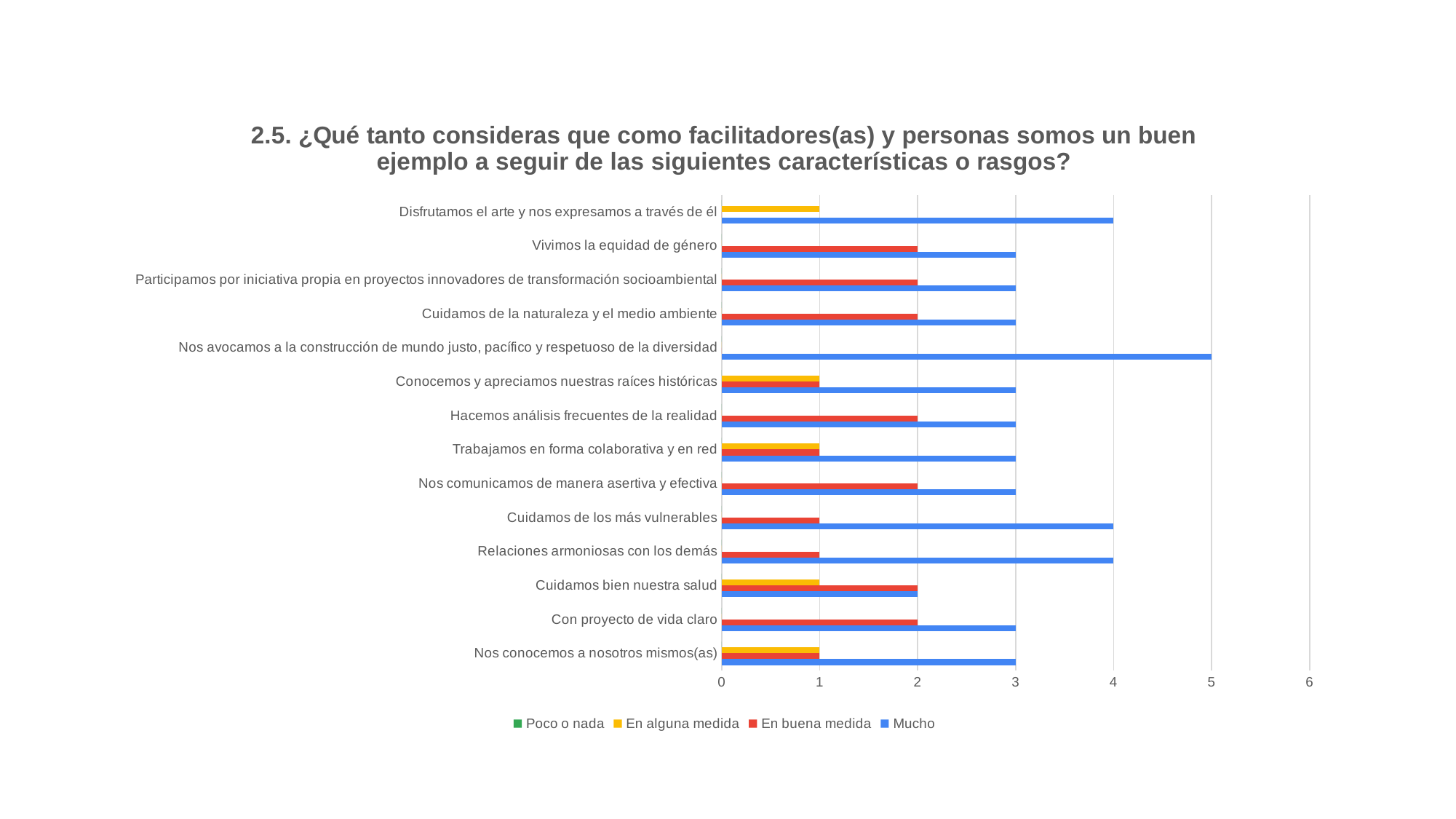
What kind of chart is shown on the slide? bar chart How many series does the legend list? 4 Which legend entry is shown in blue? Mucho Is the 'Mucho' value for 'Nos avocamos a la construcción de mundo justo, pacífico y respetuoso de la diversidad' greater or less than 4? greater What is the value of the 'Mucho' series for 'Nos avocamos a la construcción de mundo justo, pacífico y respetuoso de la diversidad'? 5 What is the value of the 'En buena medida' series for 'Vivimos la equidad de género'? 2 What is the value of the 'Mucho' series for 'Disfrutamos el arte y nos expresamos a través de él'? 4 How many categories are plotted on the chart? 14 What is the difference between the 'Mucho' value and the 'En buena medida' value for 'Cuidamos de los más vulnerables'? 3 Which is larger for 'Relaciones armoniosas con los demás': the 'Mucho' value or the 'En buena medida' value? Mucho What is the value of the 'En alguna medida' series for 'Cuidamos bien nuestra salud'? 1 Which category has the highest value for the 'Mucho' series? Nos avocamos a la construcción de mundo justo, pacífico y respetuoso de la diversidad